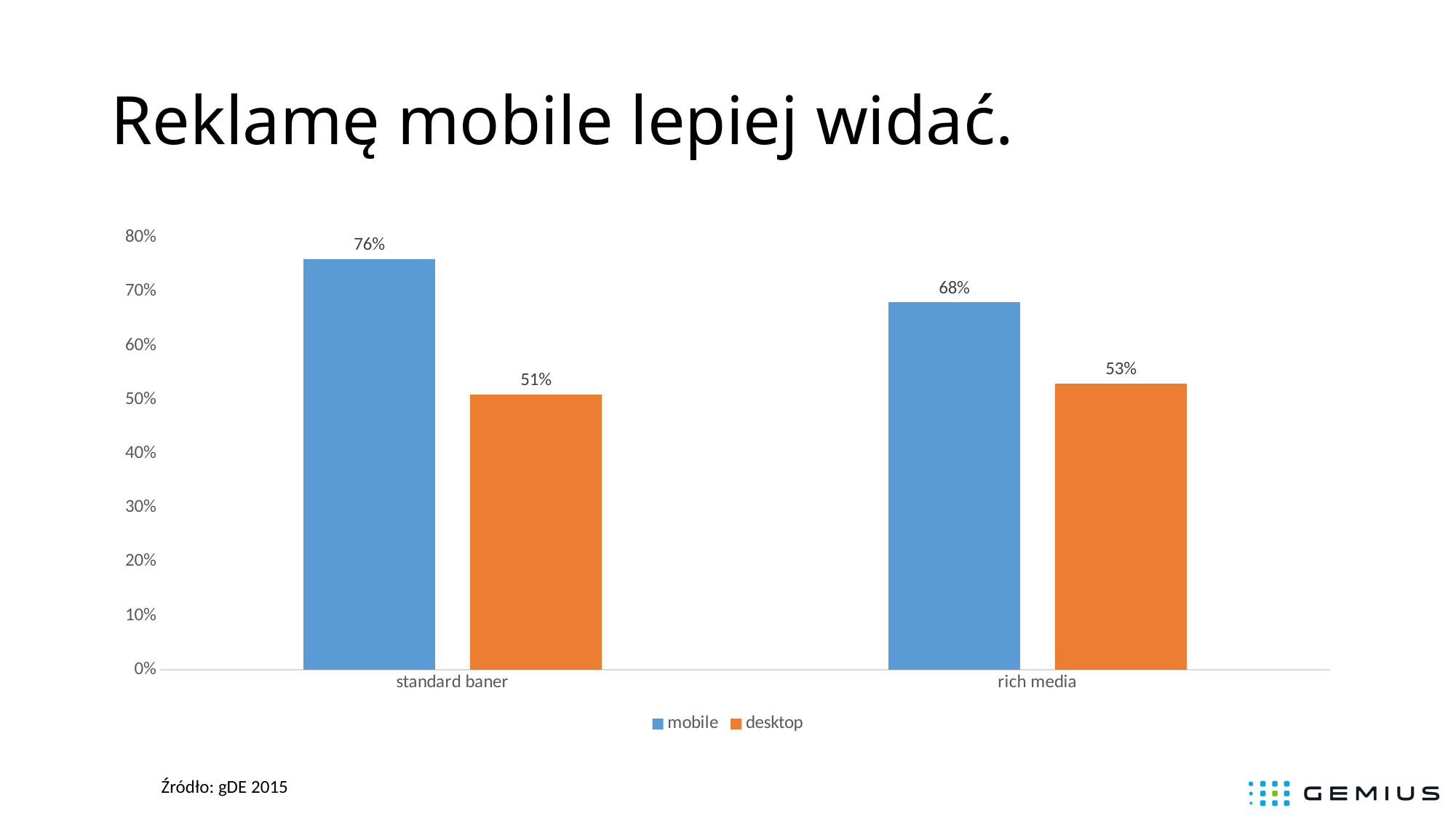
What is the value for mobile in the rich media category? 68% Which is larger: mobile for standard baner or mobile for rich media? mobile for standard baner What is the difference between mobile and desktop in the rich media category? 15% Which bar has the highest value on the chart? mobile, standard baner What is the value for mobile in the standard baner category? 76% What is the value for desktop in the rich media category? 53% What is the value for desktop in the standard baner category? 51% What is the difference between mobile and desktop in the standard baner category? 25% Which bar has the lowest value on the chart? desktop, standard baner How many series does the legend list? 2 How many categories are shown on the x axis? 2 What kind of chart is shown on the slide? bar chart